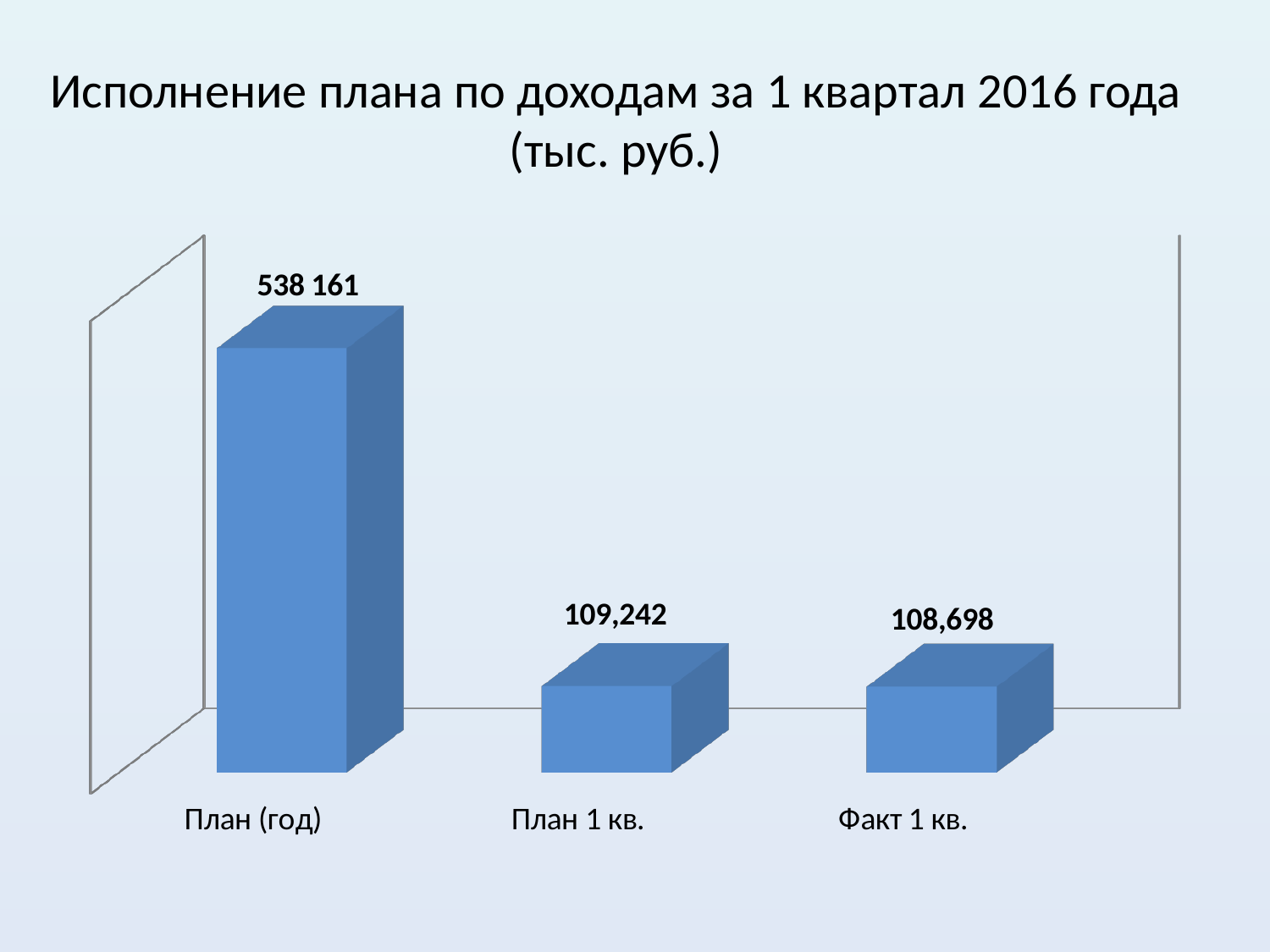
Which category has the lowest value? Факт 1 кв. What is the title of the slide? Исполнение плана по доходам за 1 квартал 2016 года (тыс. руб.) Which is larger, План (год) or План 1 кв.? План (год) Which is larger, План 1 кв. or Факт 1 кв.? План 1 кв. How many categories are shown in the chart? 3 What is the value for Факт 1 кв.? 108,698 What is the difference between План 1 кв. and Факт 1 кв.? 544 What is the value for План 1 кв.? 109,242 What unit is stated in the slide title? тыс. руб. What is the value for План (год)? 538 161 Which category has the highest value? План (год) What kind of chart is shown on the slide? Bar chart